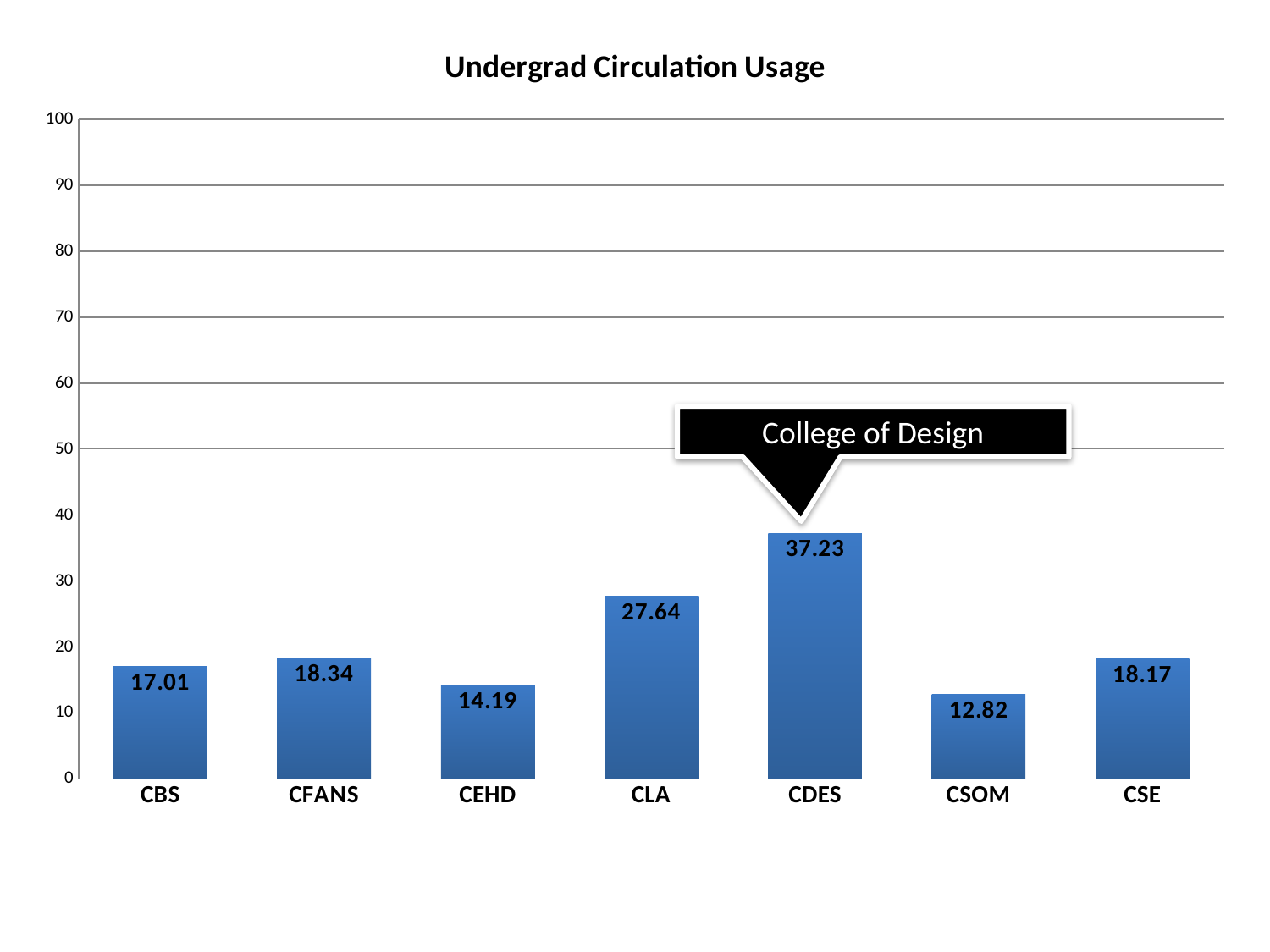
How many categories are shown on the x axis? 7 Which category has the highest value? CDES Which is larger, the value for CFANS or the value for CSE? CFANS What is the value for CLA? 27.64 What is the title of the chart? Undergrad Circulation Usage Which category has the lowest value? CSOM What is the value for CSOM? 12.82 Is the value for CLA greater or less than 30? less What is the value for CDES? 37.23 What is the value for CEHD? 14.19 What kind of chart is this? bar chart What is the difference between the values for CDES and CLA? 9.59